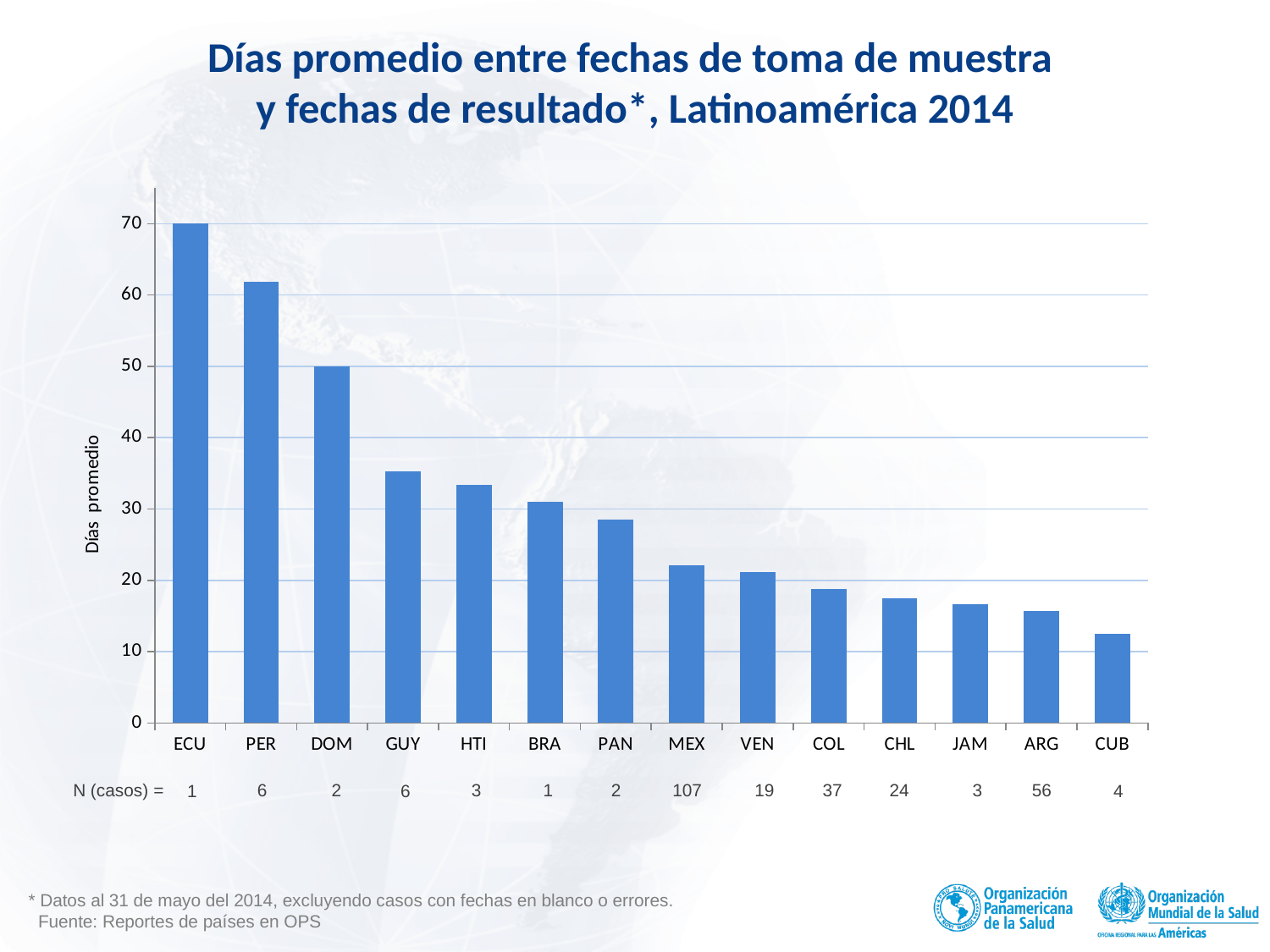
Is the value for PER greater or less than 60? greater Is the value for CHL greater or less than 20? less Is the value for BRA greater or less than 30? greater Do the values rise or fall moving from left to right along the x axis? fall What is the number of cases (N) shown for MEX below the chart? 107 Which country has the lowest average number of days between sample and result dates? CUB What kind of chart is shown on the slide? bar chart Which has a larger value, HTI or PAN? HTI How many countries are shown on the x axis of the chart? 14 Which country has the highest average number of days between sample and result dates? ECU